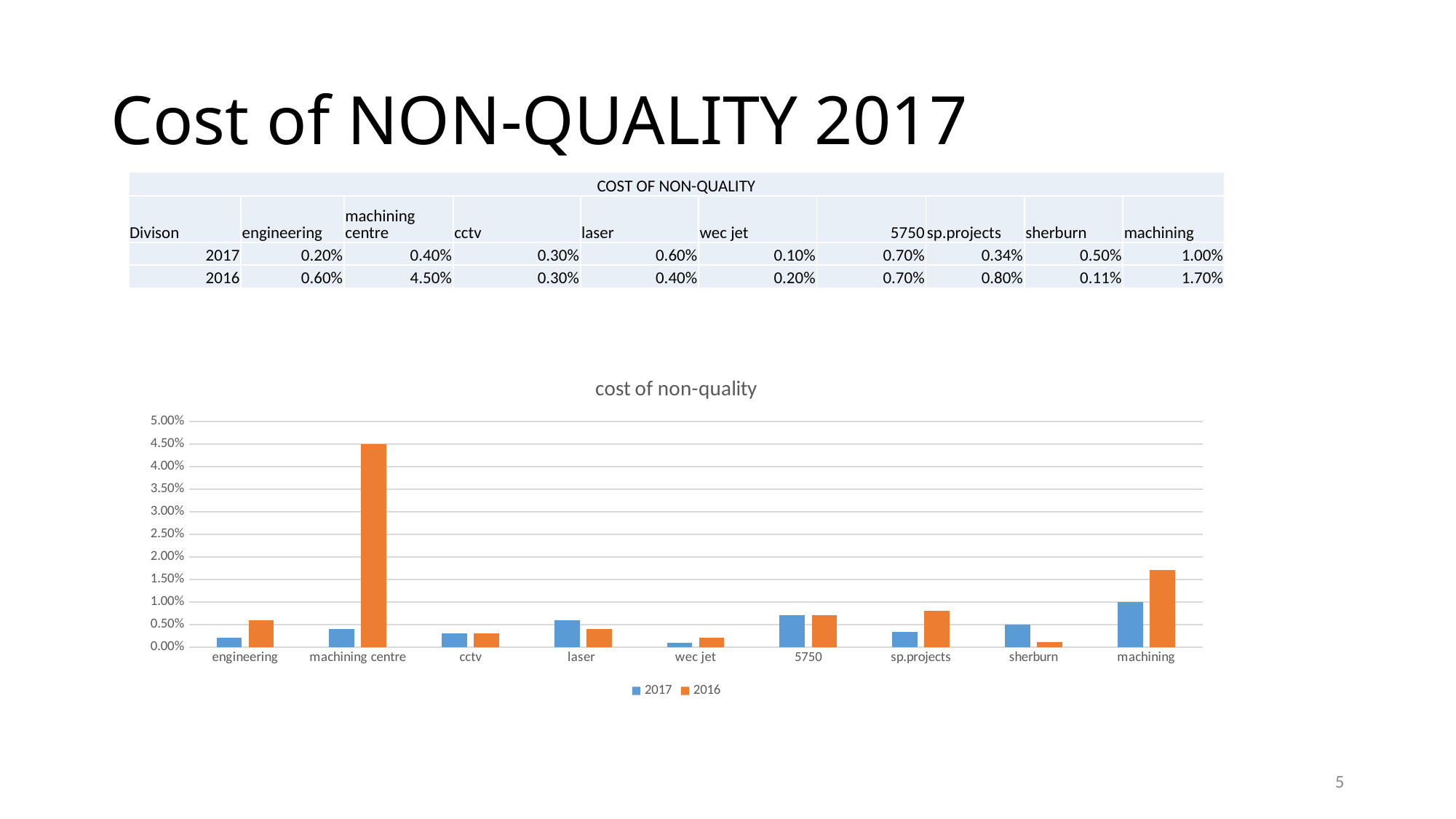
How many series does the chart legend list? 2 Which is larger for sherburn, the 2017 value or the 2016 value? 2017 What is the 2017 cost of non-quality for sp.projects? 0.34% How many divisions are shown on the x axis of the chart? 9 Is the 2016 value for machining greater or less than 1.50%? greater What is the title of the chart? cost of non-quality What is the 2016 cost of non-quality for machining centre? 4.50% What is the 2017 cost of non-quality for machining? 1.00% Which division has the lowest 2017 cost of non-quality? wec jet What type of chart is shown on the slide? bar chart What is the difference between the 2016 and 2017 values for machining centre? 4.10% Which division has the highest 2016 cost of non-quality? machining centre